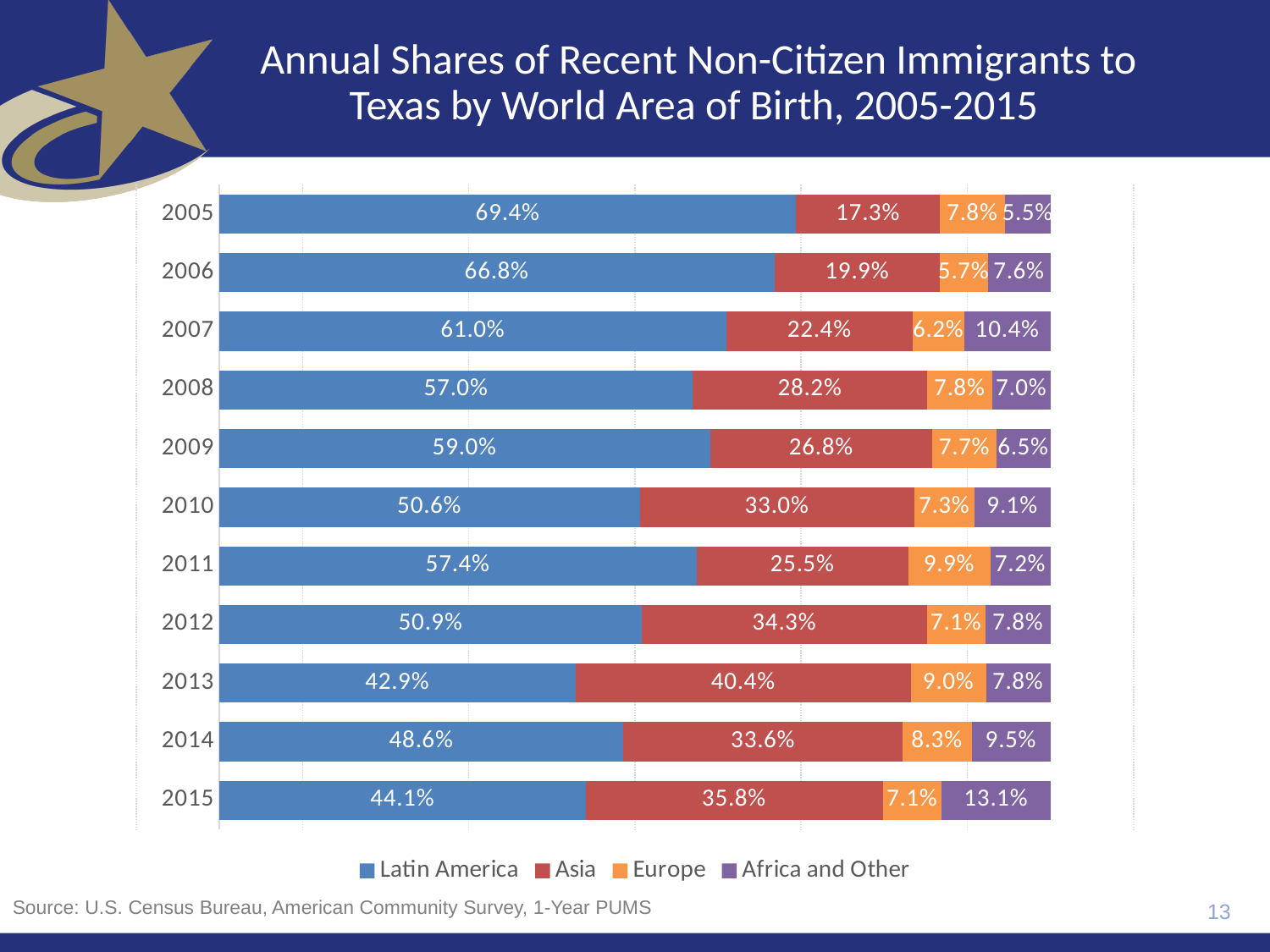
What kind of chart is shown on the slide? Stacked bar chart How many world areas of birth does the legend list? 4 What was the Europe share in 2011? 9.9% In which year was the Latin America share lowest? 2013 What share of recent non-citizen immigrants to Texas in 2005 were born in Latin America? 69.4% In which year was the Asia share highest? 2013 In 2013, which was larger: the Latin America share or the Asia share? Latin America What was the Africa and Other share in 2015? 13.1% In which year was the Latin America share highest? 2005 How many years are shown in the chart? 11 By how many percentage points did the Latin America share fall from 2005 to 2015? 25.3 percentage points What was the Asia share in 2013? 40.4%